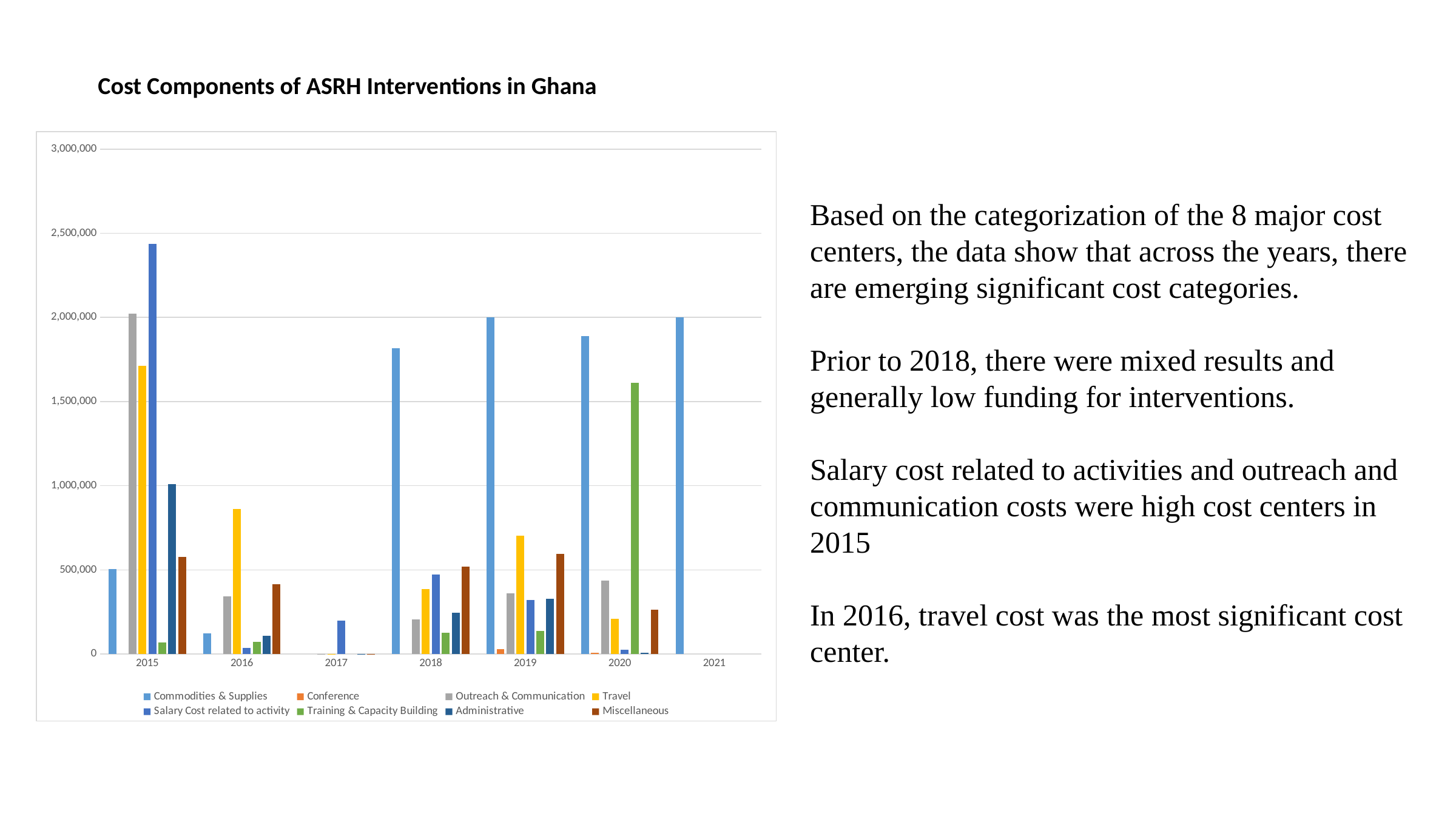
Is the value for Travel in 2016 greater or less than 1,000,000? less How many series does the legend list? 8 How many years are shown on the x axis? 7 What is the title of the chart? Cost Components of ASRH Interventions in Ghana What kind of chart is shown on the slide? bar chart Which cost category has the highest value in 2016? Travel In 2015, which is larger: Outreach & Communication or Travel? Outreach & Communication Which cost category has the highest value in 2015? Salary Cost related to activity Is the value for Training & Capacity Building in 2020 greater or less than 1,500,000? greater Is the value for Commodities & Supplies in 2018 greater or less than 1,500,000? greater